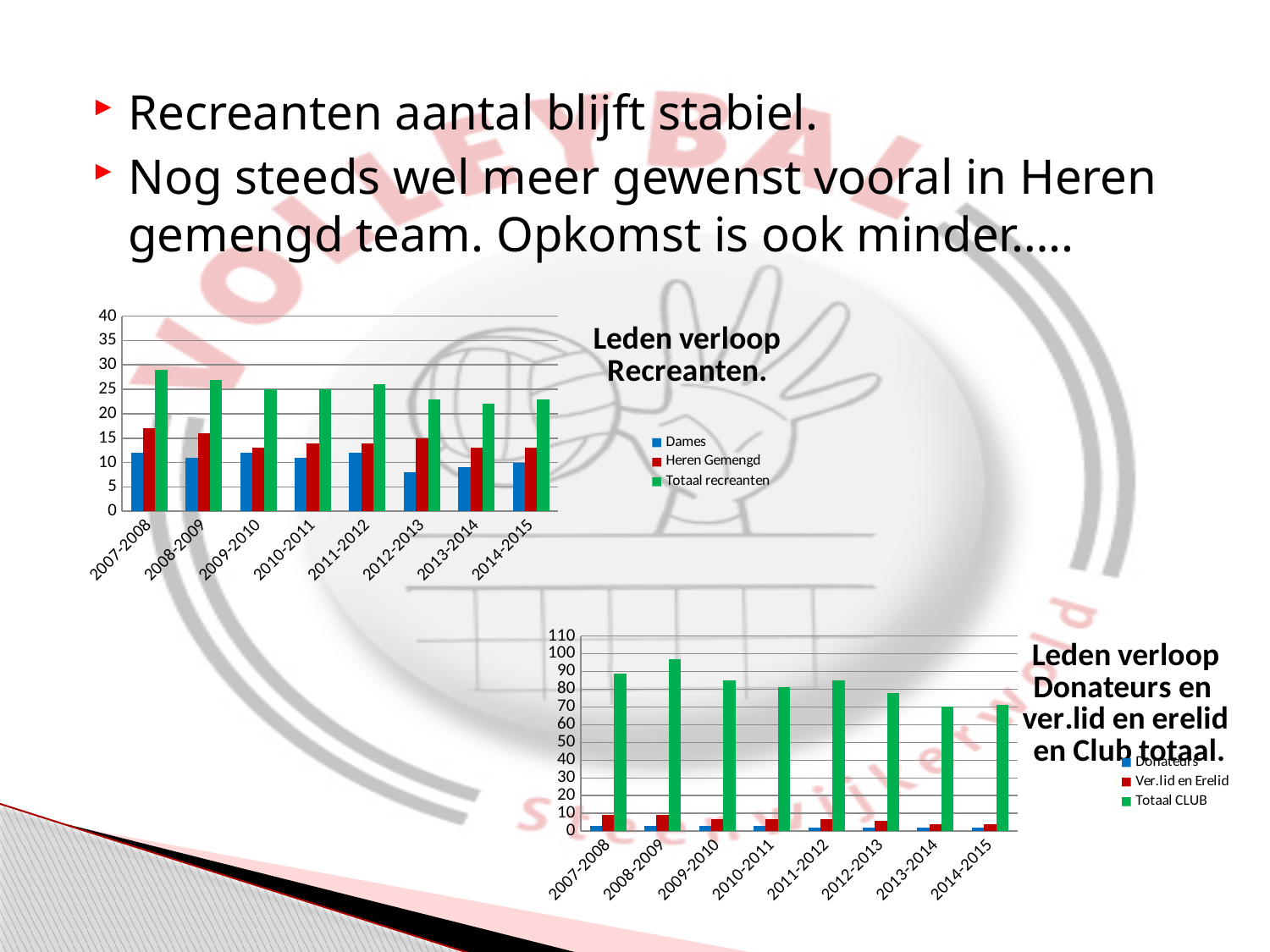
In the bottom chart ('Leden verloop Donateurs en ver.lid en erelid en Club totaal.'), is the value for Totaal CLUB in 2008-2009 greater or less than 90? greater How many seasons are shown on the x axis of the 'Leden verloop Recreanten.' chart? 8 How many series does the legend of the 'Leden verloop Recreanten.' chart list? 3 How many series does the legend of the bottom chart ('Leden verloop Donateurs en ver.lid en erelid en Club totaal.') list? 3 In the bottom chart ('Leden verloop Donateurs en ver.lid en erelid en Club totaal.'), does the Totaal CLUB value generally rise or fall from 2008-2009 to 2014-2015? fall What colour represents Totaal CLUB in the bottom chart's legend? green In the 'Leden verloop Recreanten.' chart, is the value for Dames in 2012-2013 greater or less than 10? less In the bottom chart ('Leden verloop Donateurs en ver.lid en erelid en Club totaal.'), which season has the highest value for Totaal CLUB? 2008-2009 In the 'Leden verloop Recreanten.' chart, is the value for Totaal recreanten in 2007-2008 greater or less than 25? greater In the 'Leden verloop Recreanten.' chart, which season has the highest value for Totaal recreanten? 2007-2008 In the 'Leden verloop Recreanten.' chart, which is larger in 2007-2008: Dames or Heren Gemengd? Heren Gemengd What kind of chart is the 'Leden verloop Recreanten.' chart? bar chart